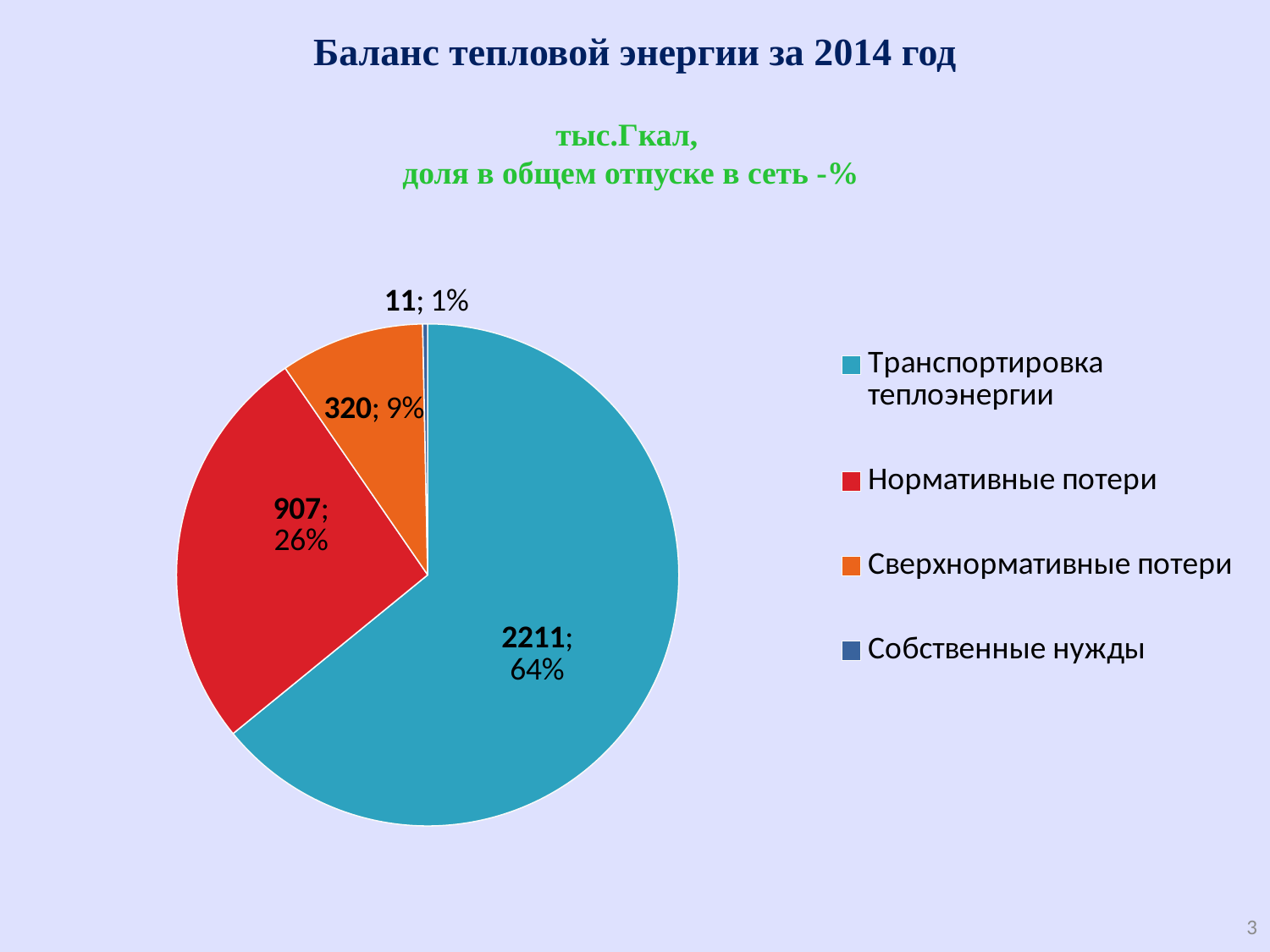
What share of the pie does Сверхнормативные потери represent? 9% What is the value for Собственные нужды? 11 Which category has the smallest slice? Собственные нужды What is the difference between the values for Нормативные потери and Сверхнормативные потери? 587 What kind of chart is shown on the slide? pie chart How many categories does the legend list? 4 Which category has the largest slice? Транспортировка теплоэнергии Which is larger, the value for Сверхнормативные потери or the value for Собственные нужды? Сверхнормативные потери What is the value for Транспортировка теплоэнергии? 2211 What is the value for Сверхнормативные потери? 320 What share of the pie does Нормативные потери represent? 26% What is the value for Нормативные потери? 907